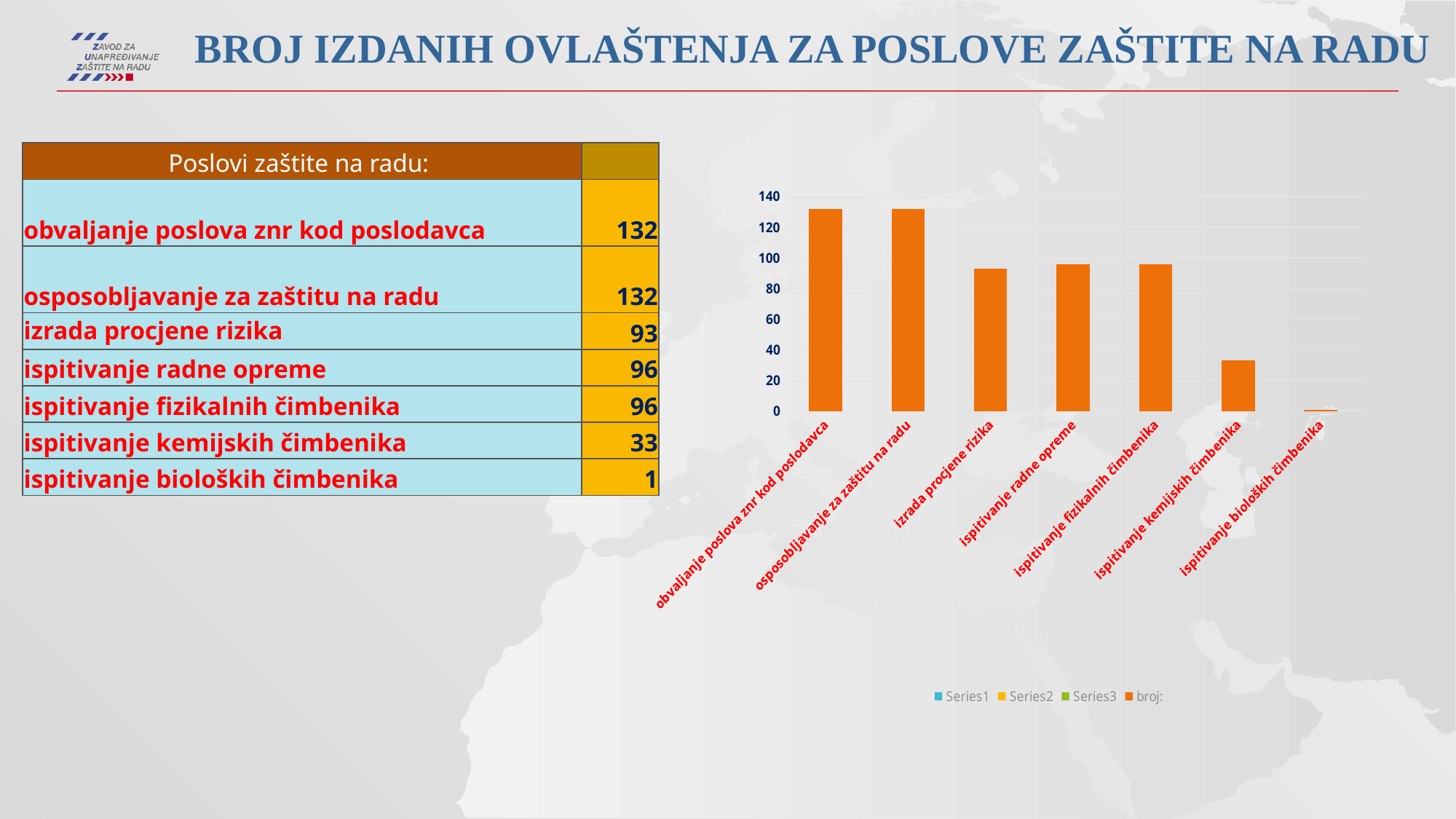
What is the difference between the values for 'obvaljanje poslova znr kod poslodavca' and 'ispitivanje kemijskih čimbenika'? 99 How many entries does the chart legend list? 4 Is the value for 'osposobljavanje za zaštitu na radu' greater or less than 120? greater What is the value for 'ispitivanje bioloških čimbenika'? 1 Is the value for 'ispitivanje kemijskih čimbenika' greater or less than 40? less Which category has the lowest value in the chart? ispitivanje bioloških čimbenika Which is larger, the value for 'ispitivanje radne opreme' or the value for 'izrada procjene rizika'? ispitivanje radne opreme What is the value for 'ispitivanje kemijskih čimbenika'? 33 What is the name of the orange series in the chart legend? broj: How many categories are plotted on the x axis of the chart? 7 What is the value for 'izrada procjene rizika'? 93 What kind of chart is shown on the slide? bar chart